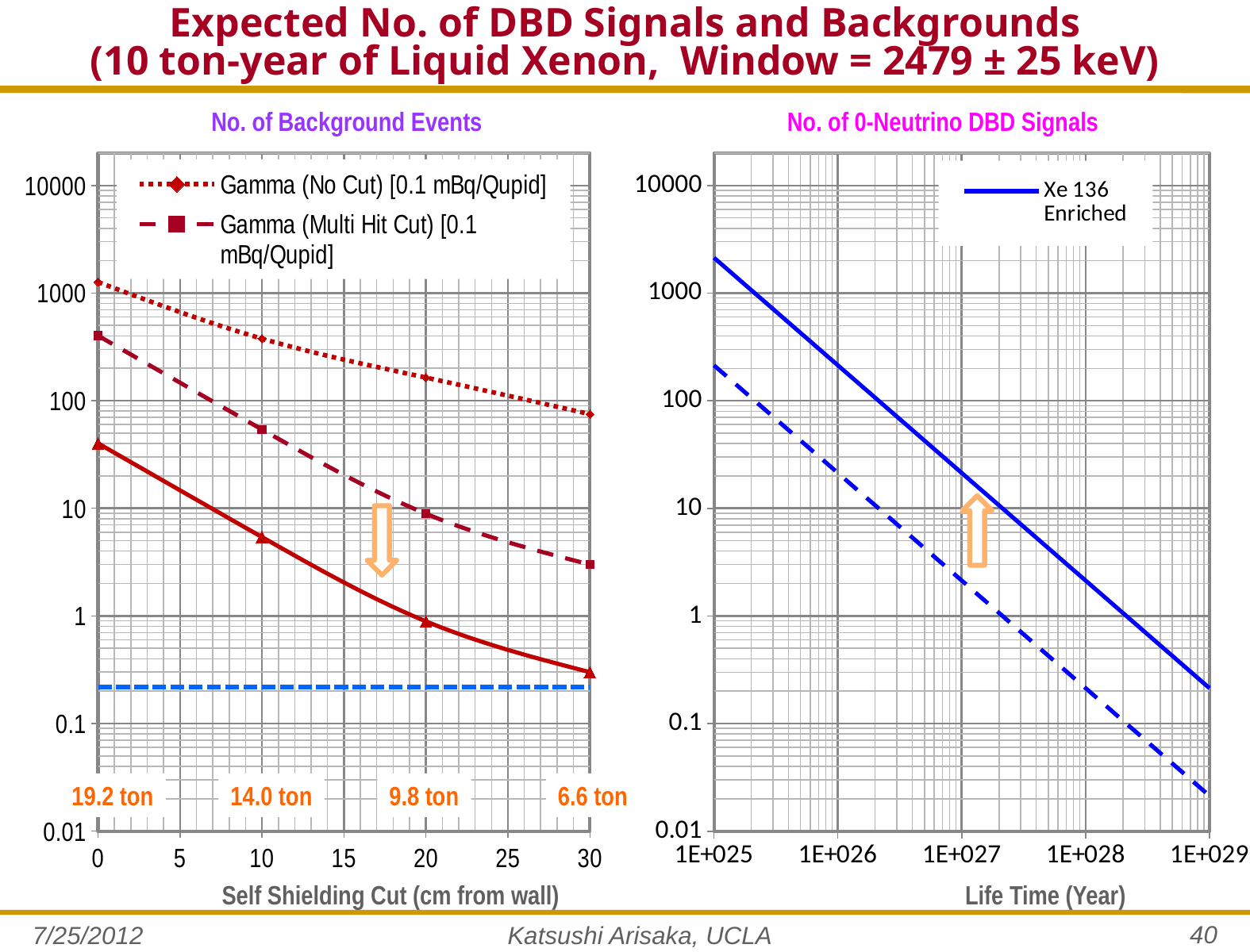
In the 'No. of 0-Neutrino DBD Signals' chart, is the Xe 136 Enriched value at a life time of 1E+025 years greater or less than 1000? greater How many series does the legend of the 'No. of Background Events' chart list? 2 In the 'No. of Background Events' chart, do the Gamma (No Cut) values rise or fall as the self shielding cut increases? fall In the 'No. of Background Events' chart, which series is higher at 20 cm: Gamma (No Cut) or Gamma (Multi Hit Cut)? Gamma (No Cut) In the 'No. of Background Events' chart, is the Gamma (Multi Hit Cut) value at 30 cm greater or less than 1? greater How many series does the legend of the 'No. of 0-Neutrino DBD Signals' chart list? 1 In the 'No. of Background Events' chart, is the Gamma (No Cut) value at 0 cm greater or less than 1000? greater In the 'No. of Background Events' chart, how many marked data points does the Gamma (No Cut) series have? 4 What is the x-axis title of the 'No. of 0-Neutrino DBD Signals' chart? Life Time (Year) What kind of chart is the 'No. of Background Events' chart on the left? line chart